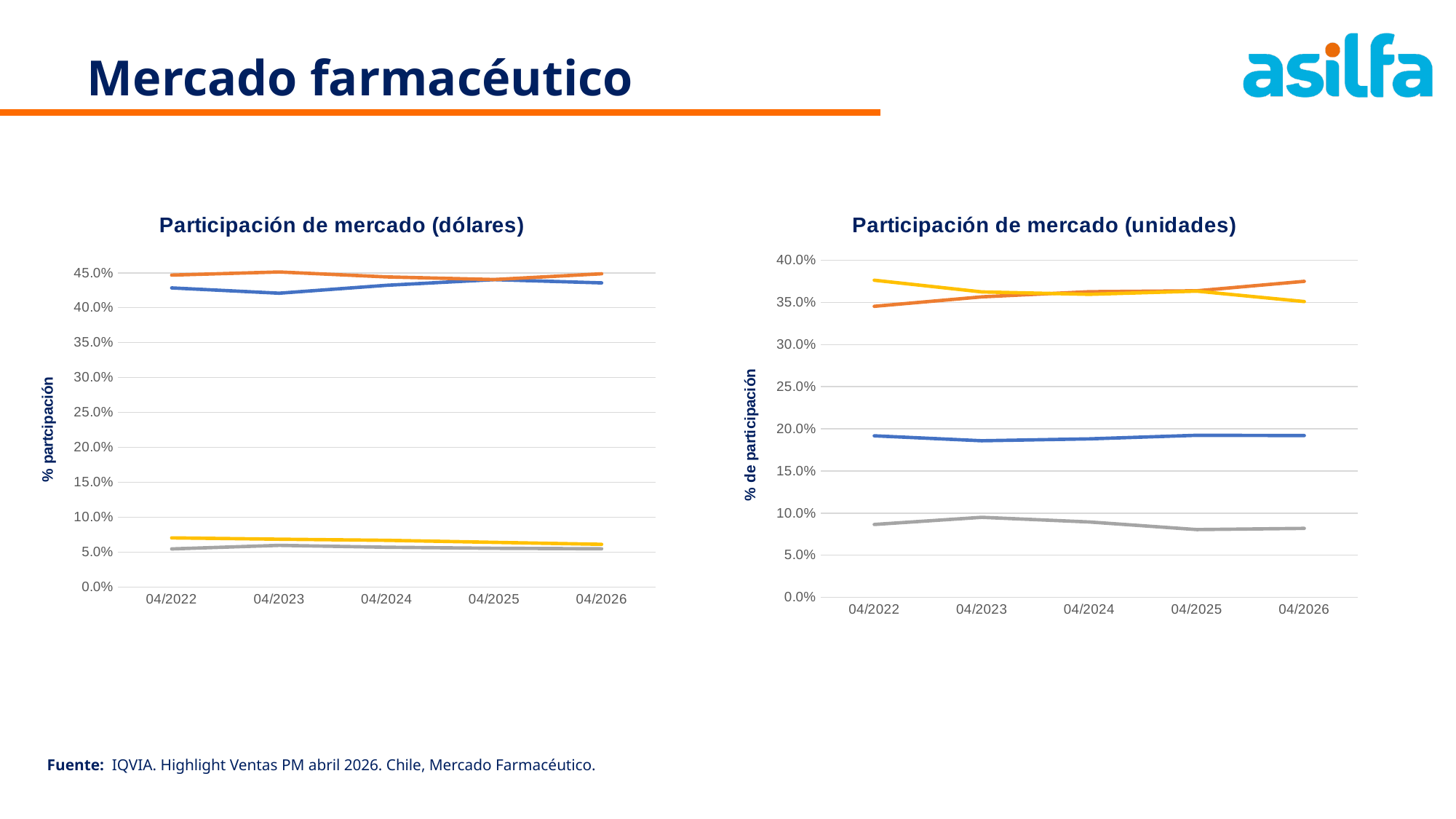
In the 'Participación de mercado (unidades)' chart, which line is higher at 04/2022, the yellow line or the orange line? the yellow line In the 'Participación de mercado (dólares)' chart, is the value of the grey line at 04/2026 greater or less than 10.0%? less What kind of chart is the 'Participación de mercado (dólares)' chart? line chart What kind of chart is the 'Participación de mercado (unidades)' chart? line chart In the 'Participación de mercado (dólares)' chart, is the value of the orange line at 04/2022 greater or less than 40.0%? greater In the 'Participación de mercado (unidades)' chart, is the value of the grey line at 04/2023 greater or less than 5.0%? greater In the 'Participación de mercado (dólares)' chart, does the yellow line rise or fall from 04/2022 to 04/2026? fall How many time points are shown on the x axis of the 'Participación de mercado (dólares)' chart? 5 In the 'Participación de mercado (dólares)' chart, which line is higher at 04/2023, the orange line or the blue line? the orange line In the 'Participación de mercado (unidades)' chart, does the orange line rise or fall from 04/2022 to 04/2026? rise What is the title of the chart on the right side of the slide? Participación de mercado (unidades)